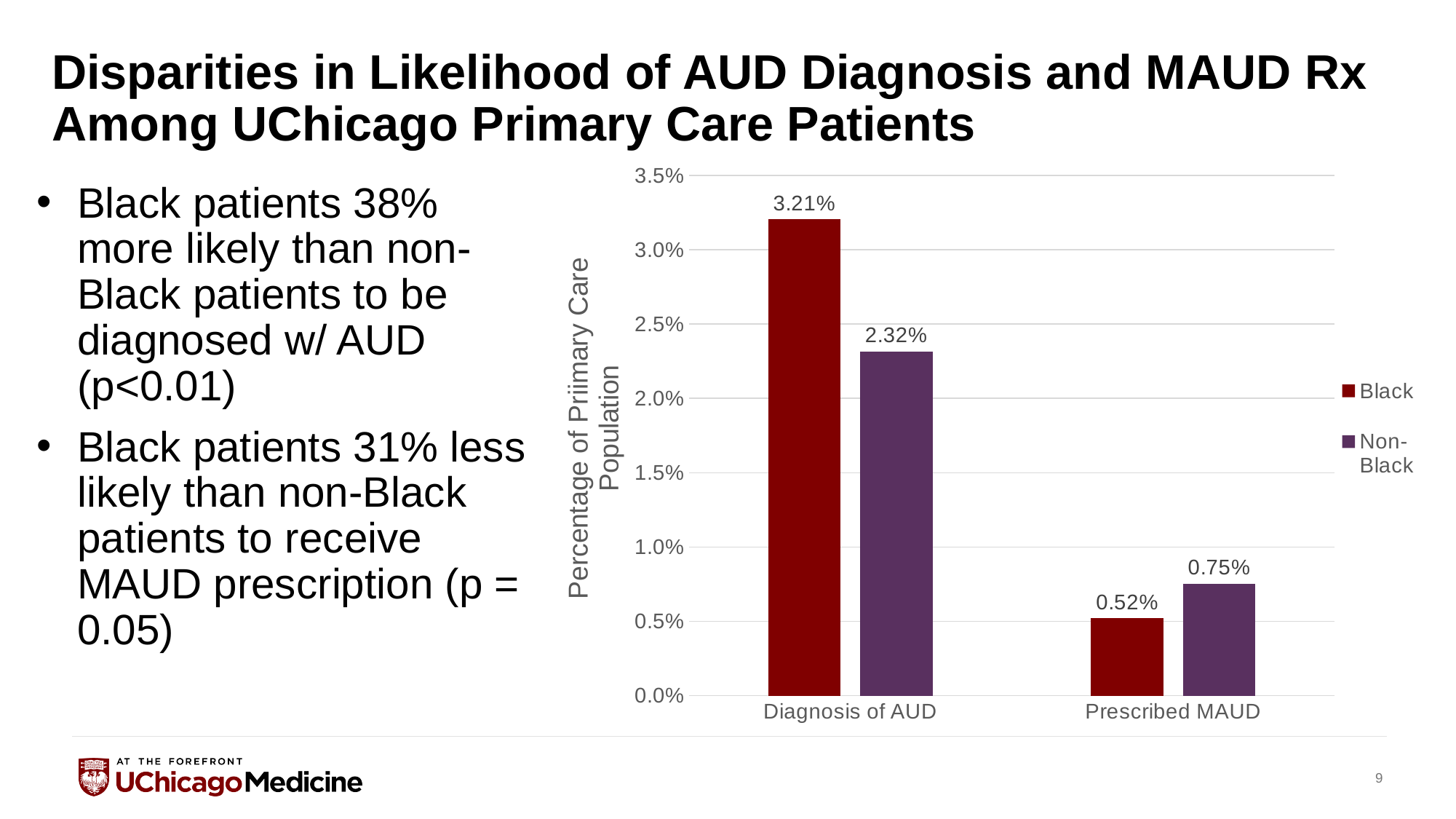
For Prescribed MAUD, which group has the larger value, Black or Non-Black? Non-Black Which bar in the chart has the highest value? Black, Diagnosis of AUD What is the difference between the Non-Black and Black values for Prescribed MAUD? 0.23% Which bar in the chart has the lowest value? Black, Prescribed MAUD What is the label of the vertical axis of the chart? Percentage of Priimary Care Population How many series does the legend list? 2 What percentage of Black patients were prescribed MAUD? 0.52% What percentage of Non-Black patients were diagnosed with AUD? 2.32% What percentage of Black patients were diagnosed with AUD? 3.21% What kind of chart is shown on the slide? Bar chart What percentage of Non-Black patients were prescribed MAUD? 0.75% What is the difference between the Black and Non-Black values for Diagnosis of AUD? 0.89%